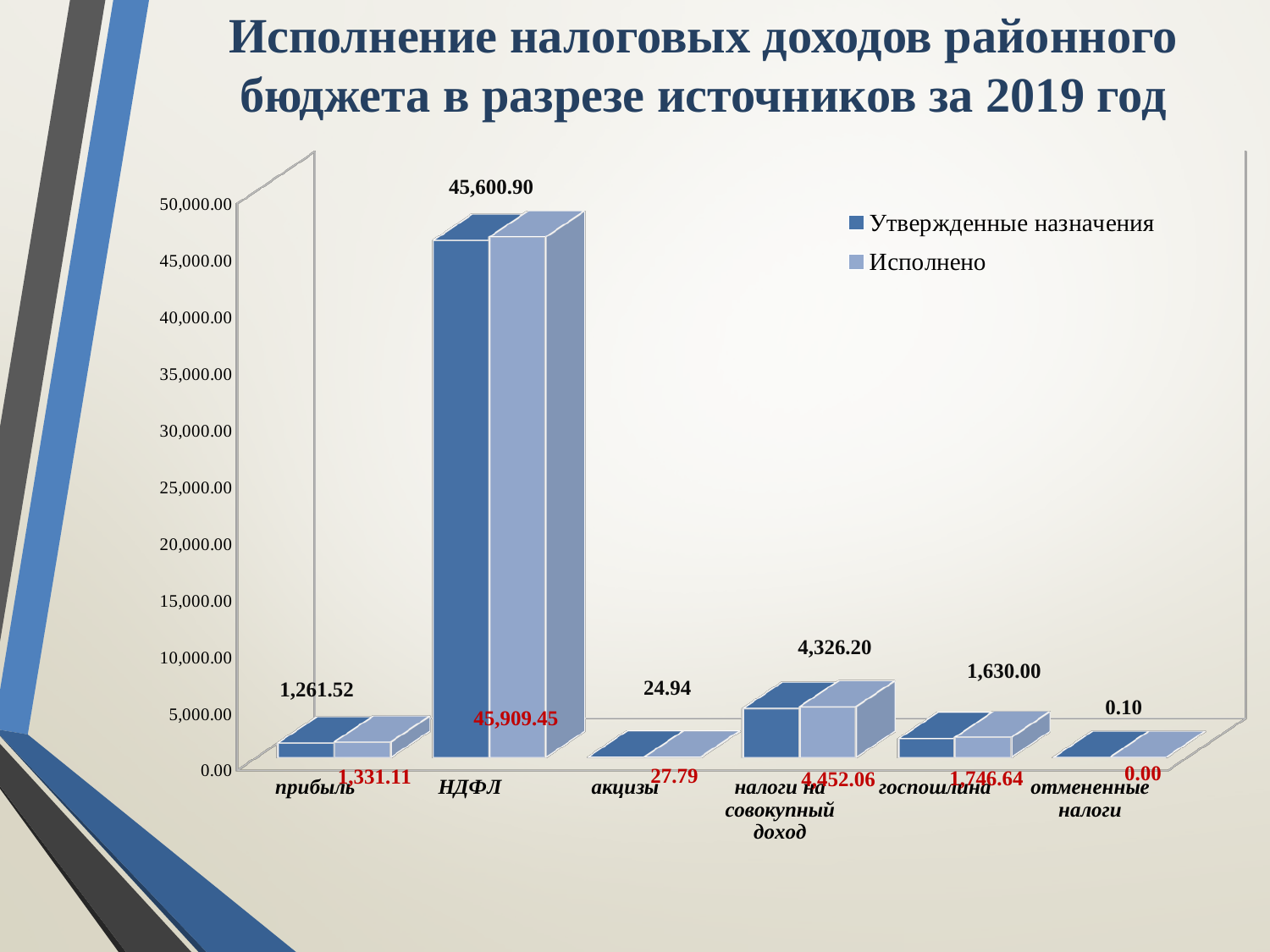
What is the value of Исполнено for прибыль? 1,331.11 What kind of chart is shown on the slide? bar chart How many categories are shown on the x axis? 6 How many series does the legend list? 2 Which is larger for акцизы: Утвержденные назначения or Исполнено? Исполнено What is the value of Утвержденные назначения for госпошлина? 1,630.00 Which category has the lowest value for Исполнено? отмененные налоги What is the value of Исполнено for НДФЛ? 45,909.45 What is the value of Утвержденные назначения for НДФЛ? 45,600.90 Which category has the highest value for Утвержденные назначения? НДФЛ What is the title of the chart on the slide? Исполнение налоговых доходов районного бюджета в разрезе источников за 2019 год What is the difference between Исполнено and Утвержденные назначения for налоги на совокупный доход? 125.86